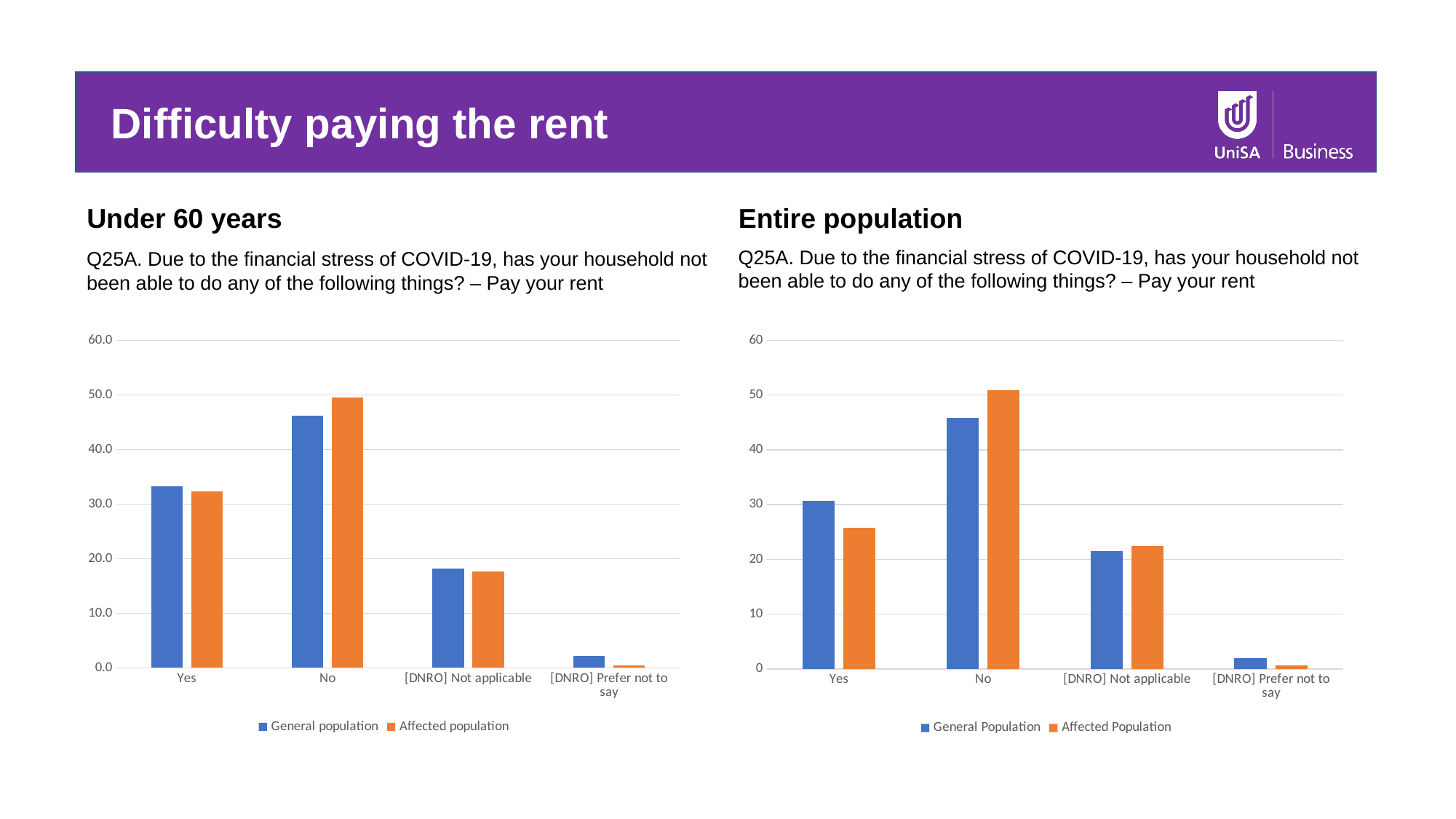
On the 'Under 60 years' chart, is the General population value for Yes greater or less than 30.0? greater On the 'Under 60 years' chart, what kind of chart is shown? Bar chart On the 'Entire population' chart, for the Yes category, which series has the larger value: General Population or Affected Population? General Population On the 'Entire population' chart, which category has the highest value for General Population? No On the 'Under 60 years' chart, how many response categories are shown on the x axis? 4 On the 'Entire population' chart, is the General Population value for No greater or less than 50? less On the 'Entire population' chart, what are the two series listed in the legend? General Population and Affected Population On the 'Entire population' chart, is the Affected Population value for Yes greater or less than 30? less On the 'Under 60 years' chart, which category has the lowest value for General population? [DNRO] Prefer not to say On the 'Under 60 years' chart, how many series does the legend list? 2 On the 'Under 60 years' chart, for the No category, which series has the larger value: General population or Affected population? Affected population On the 'Under 60 years' chart, which category has the highest value for Affected population? No